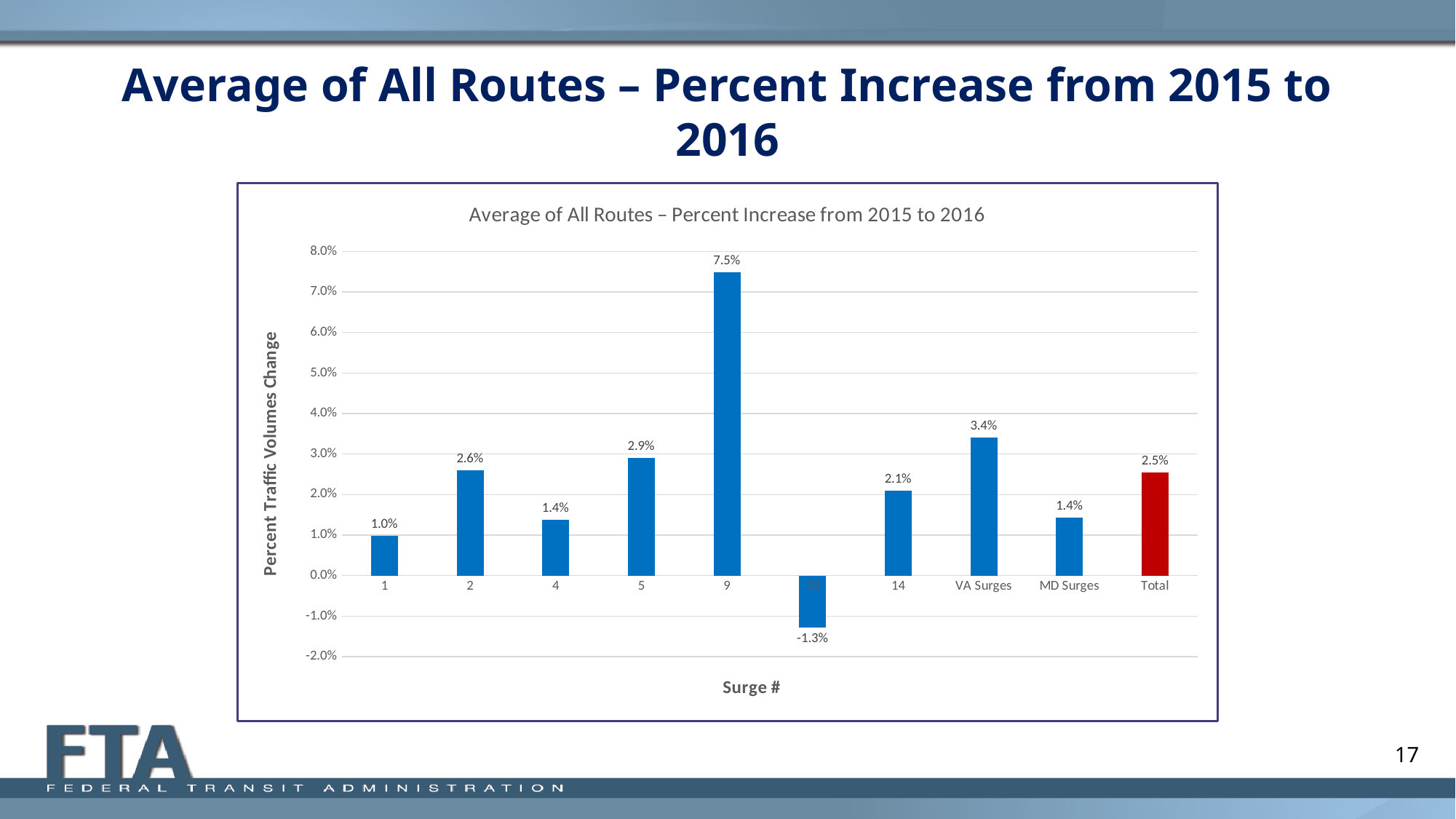
What is the value for Total? 2.5% What kind of chart is shown on the slide? Bar chart What is the difference between the values for Surge 5 and Surge 1? 1.9% Which category has the highest value? 9 What is the value for Surge 2? 2.6% Which is larger, the value for Surge 14 or the value for MD Surges? Surge 14 What is the value for VA Surges? 3.4% What is the difference between the values for Surge 9 and VA Surges? 4.1% What is the value of the only bar that extends below 0.0%? -1.3% What is the value for Surge 9? 7.5% What is the label of the y axis? Percent Traffic Volumes Change How many categories are shown on the x axis? 10